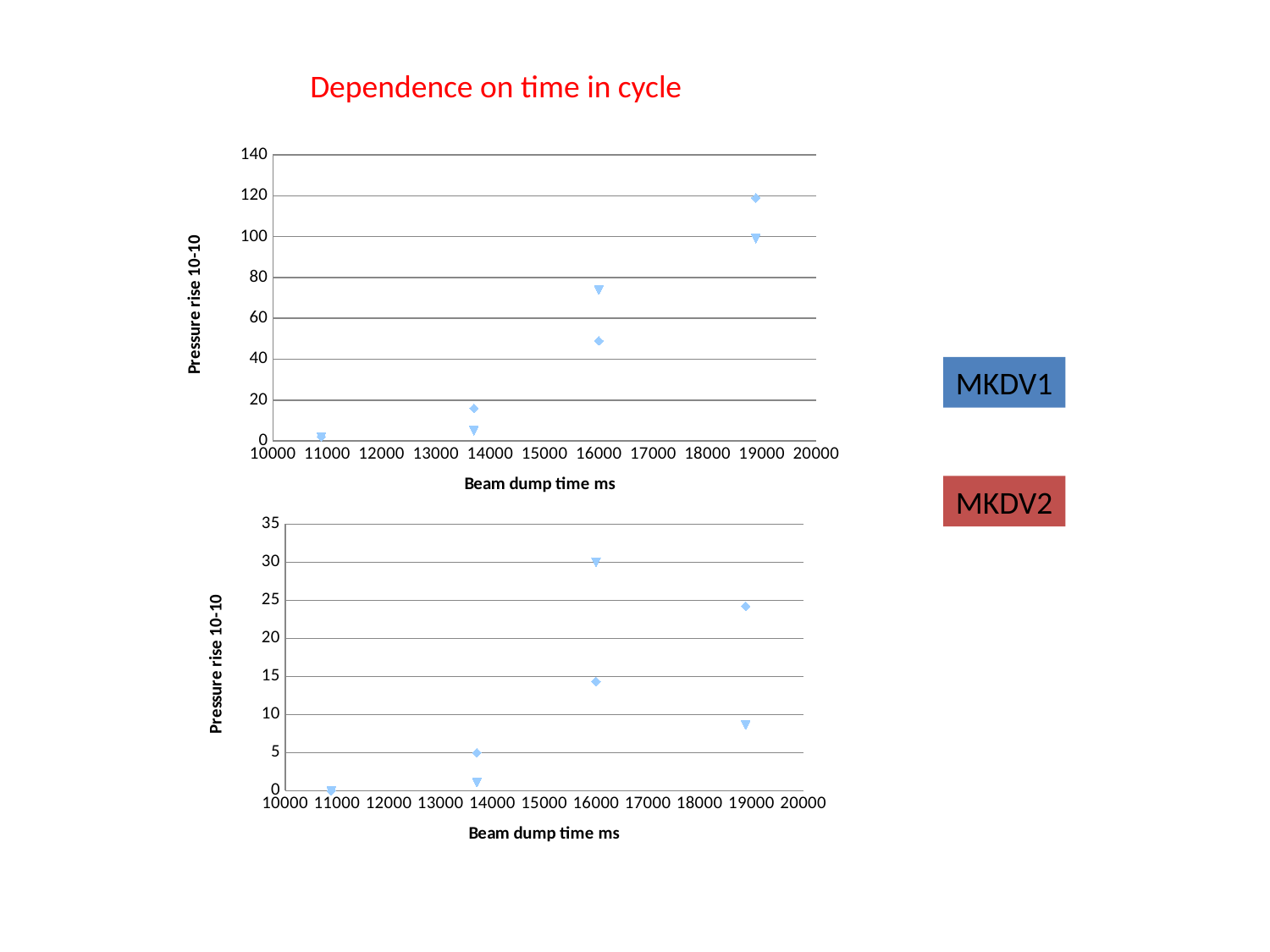
In the top chart, is the highest diamond point greater or less than 100? greater In the bottom chart, is the highest triangle point greater or less than 25? greater What is the x-axis title of the top chart? Beam dump time ms In the bottom chart, is the diamond point near 19000 ms greater or less than 20? greater In the top chart, at about 16000 ms, which marker has the higher pressure rise, the diamond or the triangle? triangle What is the y-axis title of the bottom chart? Pressure rise 10-10 In the top chart, do the diamond points rise or fall as beam dump time increases? rise What kind of chart is the top chart on the slide? scatter chart